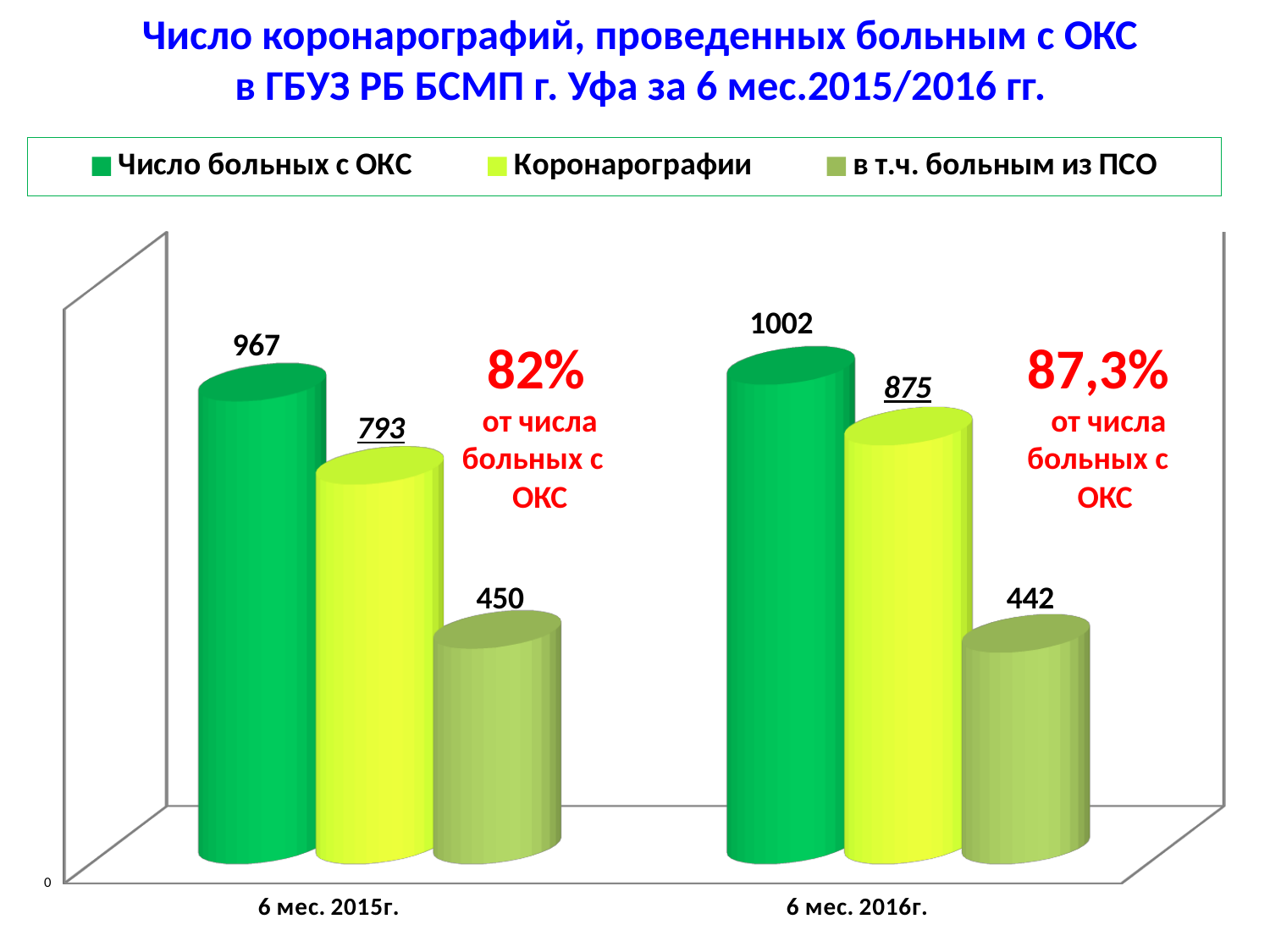
What is the difference between 'Число больных с ОКС' and 'Коронарографии' for '6 мес. 2015г.'? 174 What is the value of 'в т.ч. больным из ПСО' for '6 мес. 2015г.'? 450 How many categories are shown on the x axis? 2 Which series has the highest value for '6 мес. 2015г.'? Число больных с ОКС What kind of chart is shown on the slide? Bar chart Which is larger: 'в т.ч. больным из ПСО' for '6 мес. 2015г.' or for '6 мес. 2016г.'? 6 мес. 2015г. What is the value of 'Число больных с ОКС' for '6 мес. 2016г.'? 1002 Which series has the lowest value for '6 мес. 2016г.'? в т.ч. больным из ПСО What is the difference in 'Коронарографии' between '6 мес. 2016г.' and '6 мес. 2015г.'? 82 How many series does the legend list? 3 What is the value of 'Коронарографии' for '6 мес. 2016г.'? 875 What is the value of 'Число больных с ОКС' for '6 мес. 2015г.'? 967